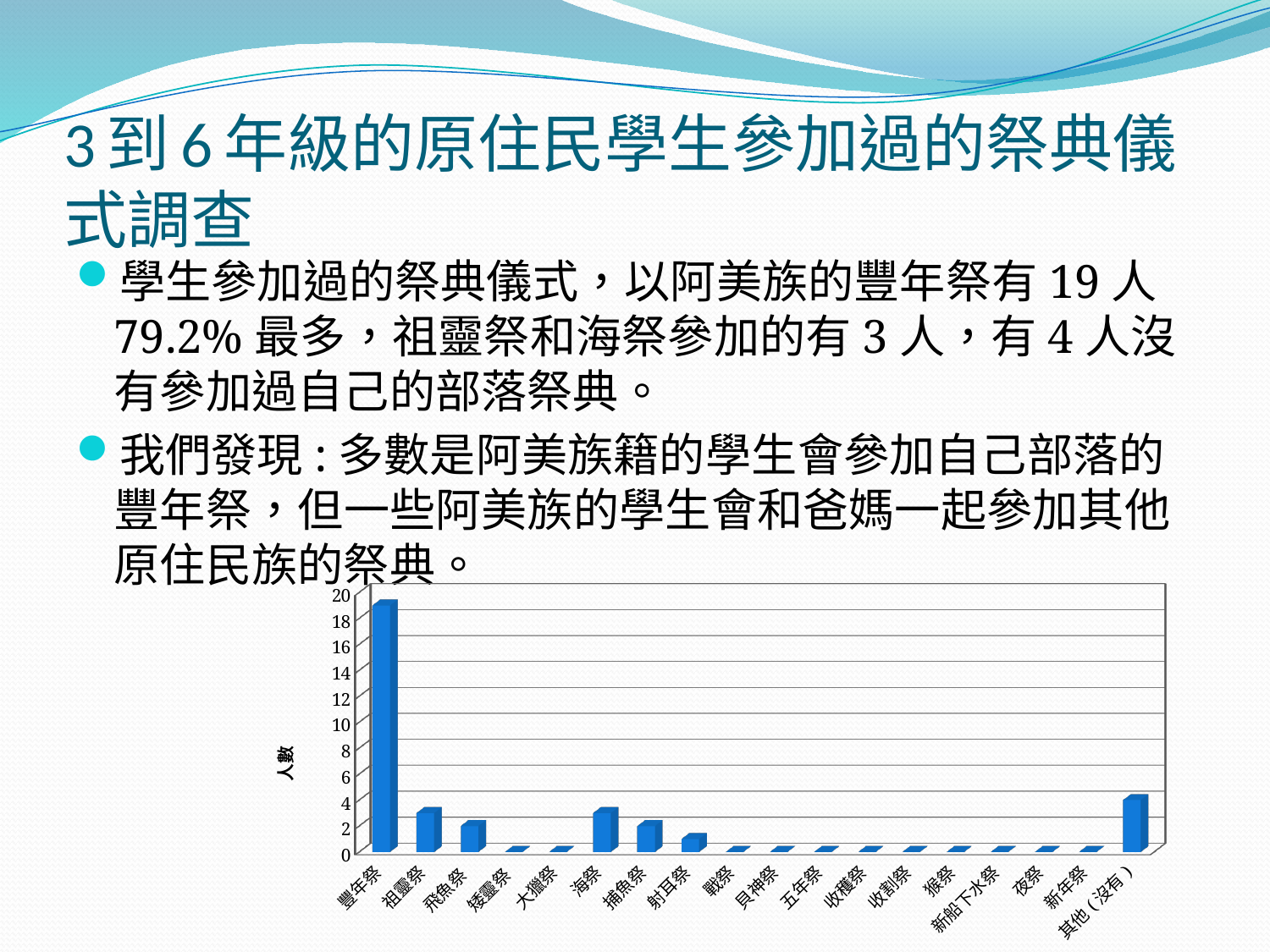
What is the value for 豐年祭? 19 What is the label of the vertical axis of the chart? 人數 How many categories are shown on the x axis of the chart? 18 What is the difference between the values for 豐年祭 and 其他(沒有)? 15 Which category has the highest value in the chart? 豐年祭 What is the value for 海祭? 3 Which is larger, the value for 豐年祭 or the value for 其他(沒有)? 豐年祭 What is the value for 其他(沒有)? 4 Is the value for 飛魚祭 greater or less than 4? less What kind of chart is shown on the slide? bar chart What is the value for 祖靈祭? 3 Is the value for 射耳祭 greater or less than 2? less